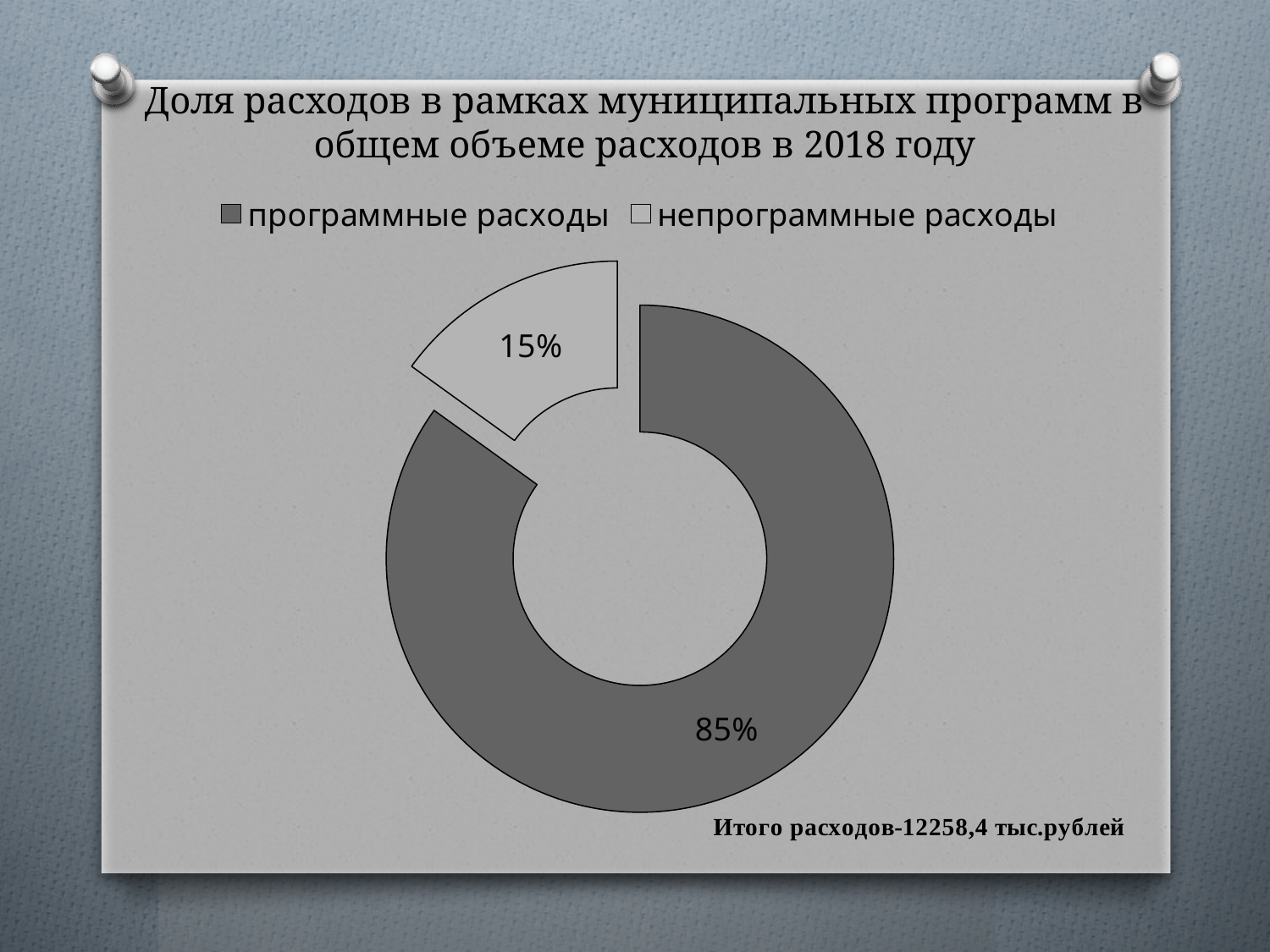
What is the title of the chart? Доля расходов в рамках муниципальных программ в общем объеме расходов в 2018 году How many entries does the legend list? 2 Which category has the largest share of the chart? программные расходы How many categories are shown in the chart? 2 What share of the chart is labelled for программные расходы? 85% What kind of chart is shown on the slide? doughnut (pie) chart Which category has the smallest share of the chart? непрограммные расходы What is the difference in percentage points between программные расходы and непрограммные расходы? 70 What share of the chart is labelled for непрограммные расходы? 15% What total expenditure amount is stated on the slide? 12258,4 тыс.рублей Which is larger, the share for программные расходы or for непрограммные расходы? программные расходы